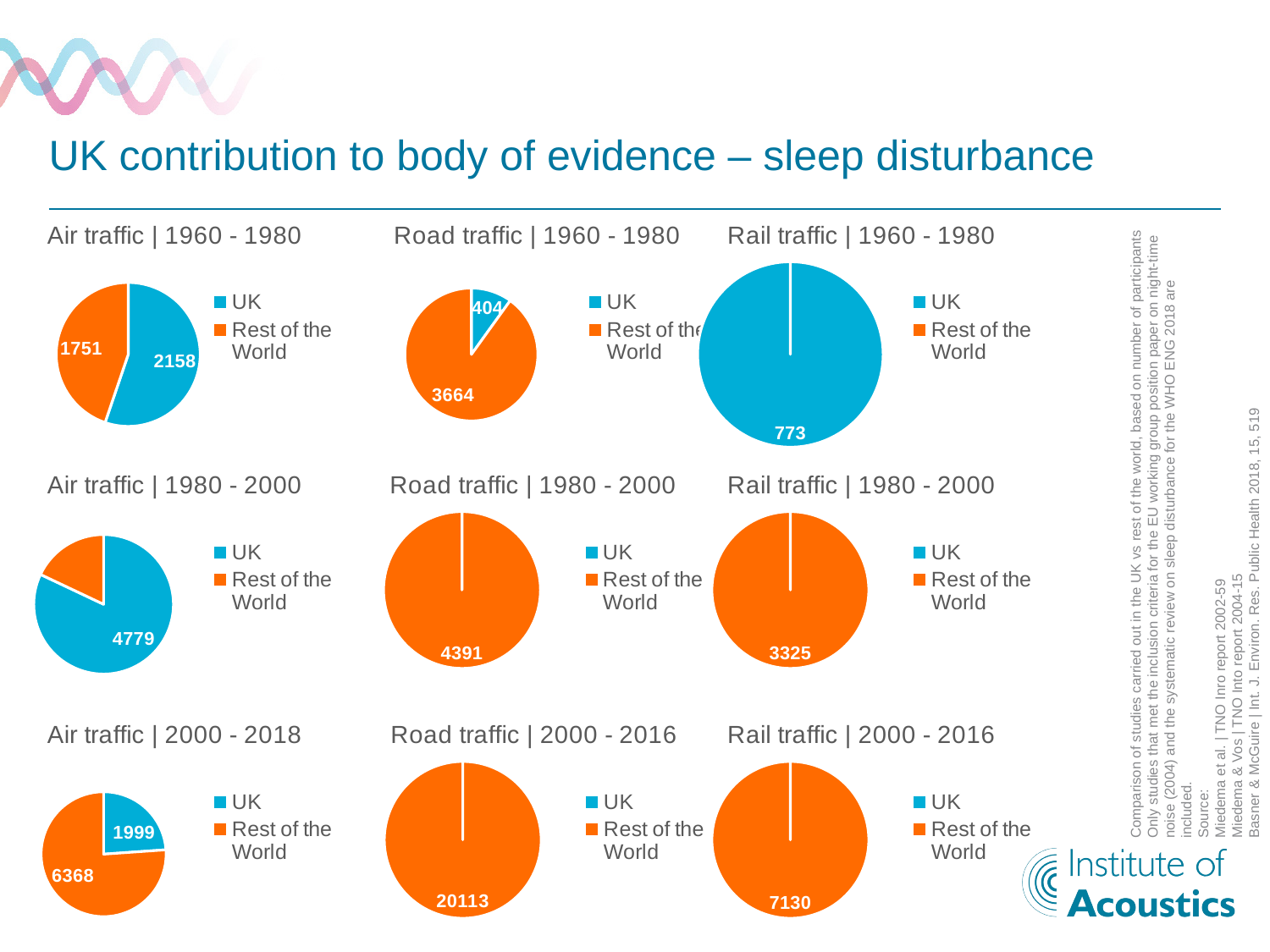
In the 'Road traffic | 1960 - 1980' chart, what is the value for Rest of the World? 3664 In the 'Air traffic | 1960 - 1980' chart, what is the value for Rest of the World? 1751 How many series does the legend of the 'Air traffic | 1980 - 2000' chart list? 2 In the 'Road traffic | 1960 - 1980' chart, what is the value for UK? 404 In the 'Air traffic | 2000 - 2018' chart, what is the value for UK? 1999 In the 'Air traffic | 1960 - 1980' chart, what is the value for UK? 2158 In the 'Road traffic | 1960 - 1980' chart, which is larger, UK or Rest of the World? Rest of the World How many pie charts are shown on the slide? 9 In the 'Air traffic | 2000 - 2018' chart, what is the total of the UK and Rest of the World values? 8367 In the 'Air traffic | 1960 - 1980' chart, what is the difference between the UK value and the Rest of the World value? 407 What kind of chart is the 'Rail traffic | 1980 - 2000' chart? Pie chart In the 'Road traffic | 2000 - 2016' chart, what is the value for Rest of the World? 20113